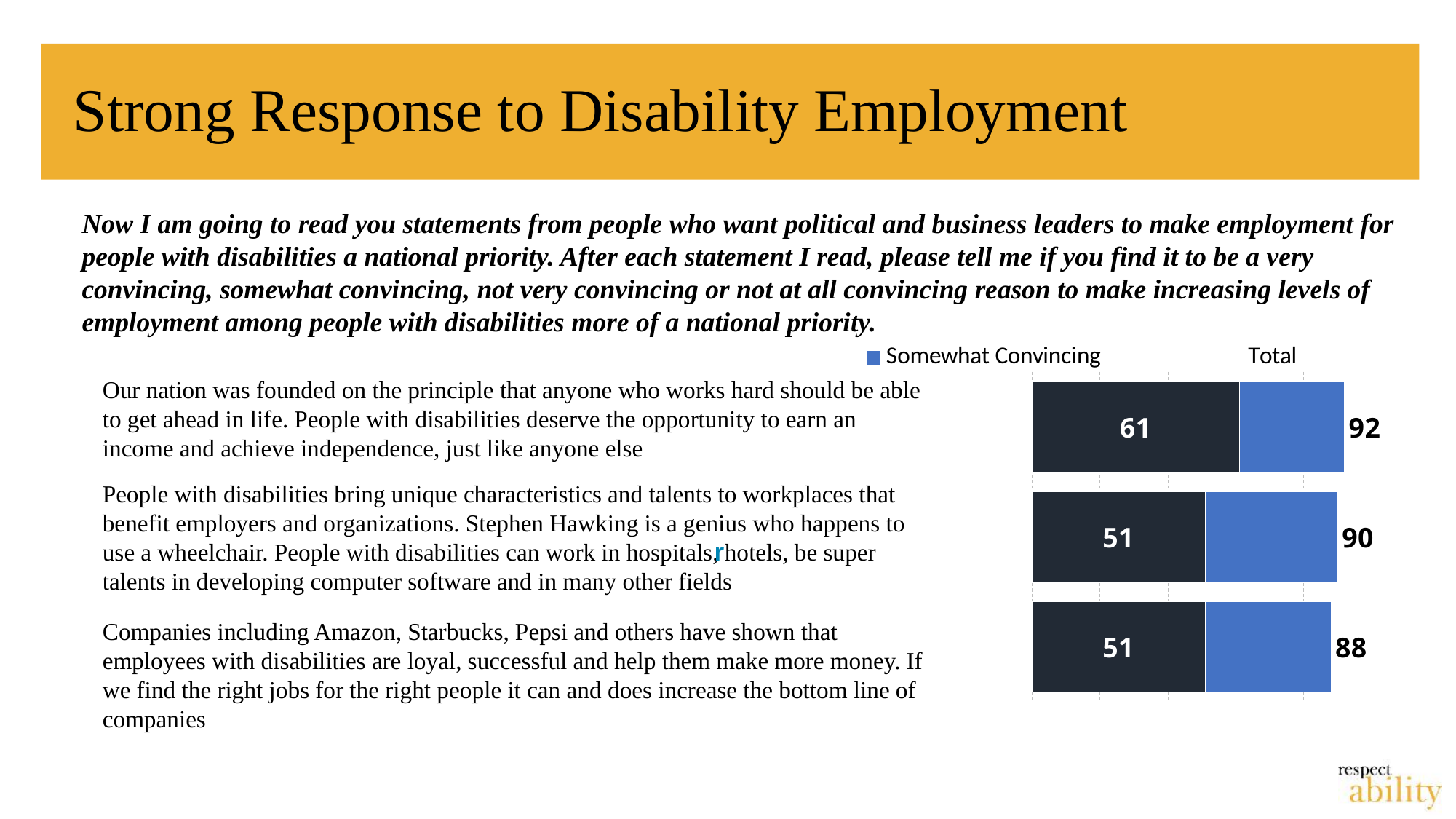
What is the value printed on the dark segment of the bar for the statement that our nation was founded on the principle that anyone who works hard should be able to get ahead? 61 What kind of chart is shown on the slide? Stacked horizontal bar chart Which is larger: the Total for the Stephen Hawking statement or the Total for the Amazon, Starbucks, Pepsi statement? The Stephen Hawking statement (90) What is the Total shown for the statement mentioning Amazon, Starbucks and Pepsi? 88 Which legend entry is marked with the blue square? Somewhat Convincing What is the value printed on the dark segment of the bottom bar (the Amazon, Starbucks, Pepsi statement)? 51 Which statement has the highest Total? The top statement (our nation was founded on the principle that anyone who works hard should be able to get ahead) Which statement has the lowest Total? The bottom statement (Companies including Amazon, Starbucks, Pepsi) What is the difference between the Total for the top statement and the Total for the bottom statement? 4 How many bars (statements) are plotted in the chart? 3 What is the Total shown for the statement mentioning Stephen Hawking? 90 How much larger is the dark segment value of the top bar than the dark segment value of the middle bar? 10